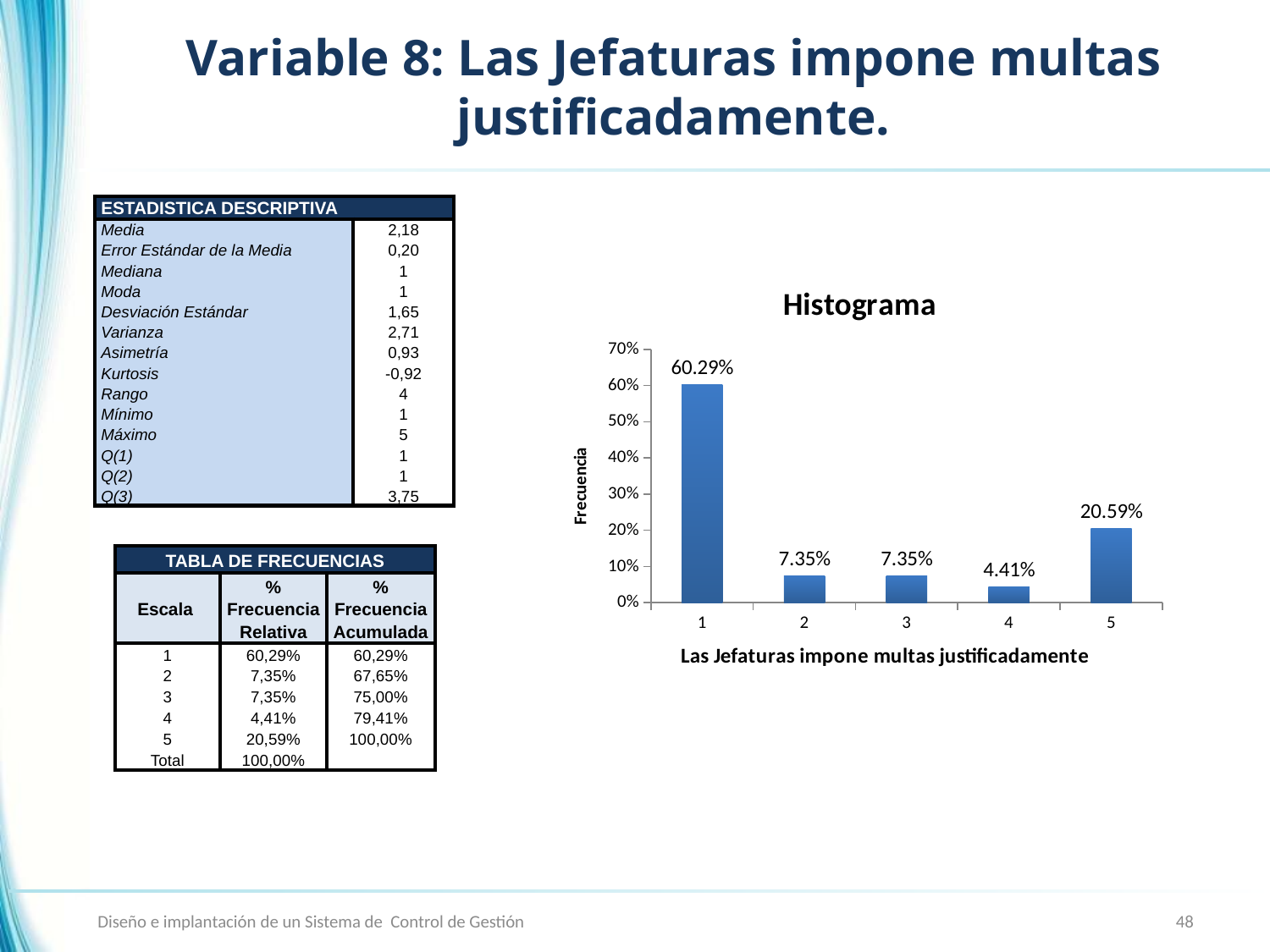
Which category has the lowest value in the Histograma chart? 4 What is the value for category 1 in the Histograma chart? 60.29% Which category has the highest value in the Histograma chart? 1 Which is larger in the Histograma chart, the value for category 2 or category 5? 5 What is the difference between the values for category 1 and category 5 in the Histograma chart? 39.70% Is the value for category 1 in the Histograma chart greater or less than 50%? greater How many categories are shown on the x axis of the Histograma chart? 5 What is the value for category 4 in the Histograma chart? 4.41% What kind of chart is the Histograma chart? bar chart What is the difference between the values for category 5 and category 4 in the Histograma chart? 16.18% What is the label of the y axis of the Histograma chart? Frecuencia What is the value for category 5 in the Histograma chart? 20.59%